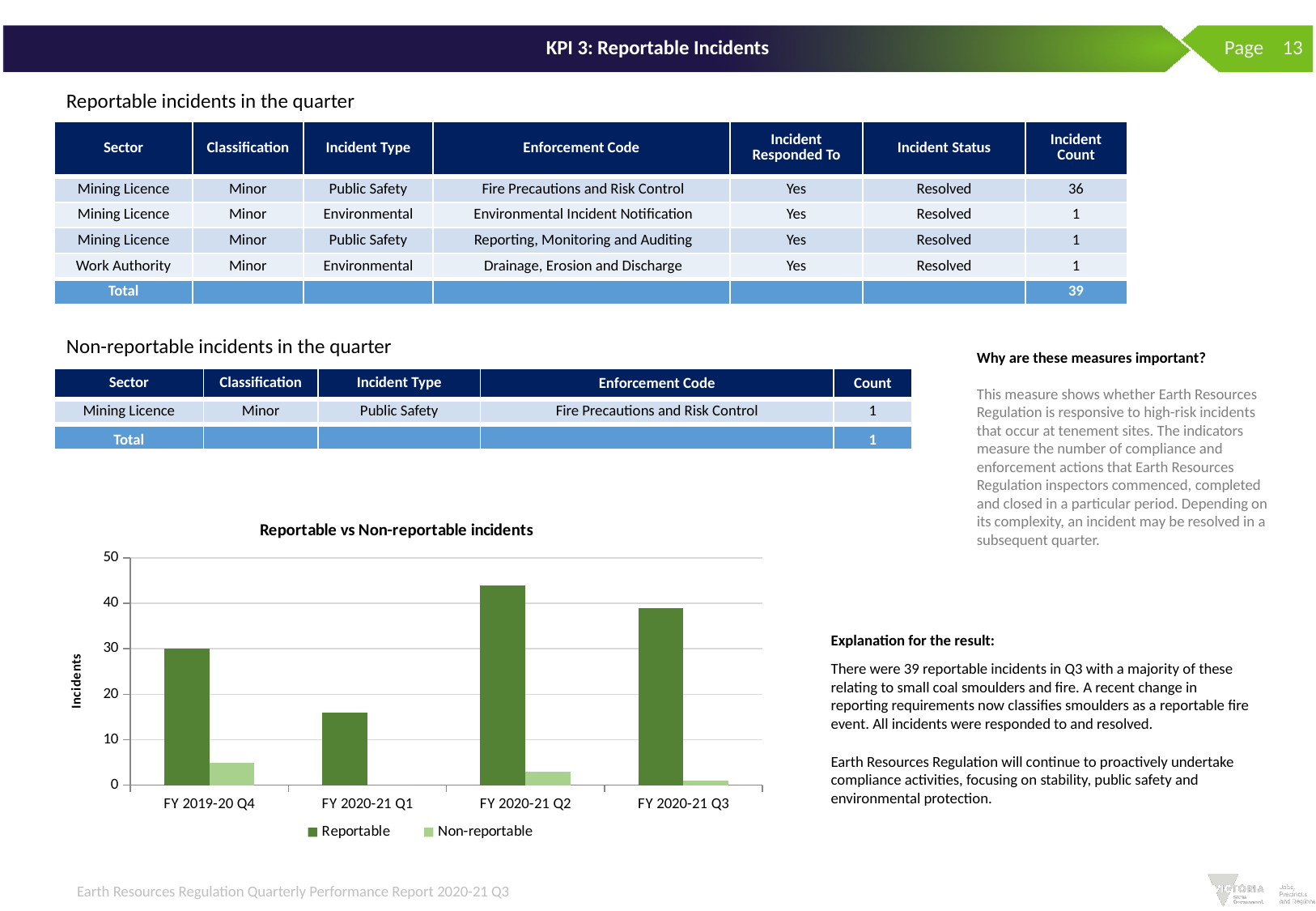
In the 'Reportable vs Non-reportable incidents' chart, which quarter has the highest Non-reportable value? FY 2019-20 Q4 What is the label on the y axis of the 'Reportable vs Non-reportable incidents' chart? Incidents In the 'Reportable vs Non-reportable incidents' chart, is the Reportable value for FY 2020-21 Q2 greater or less than 40? greater In the 'Reportable vs Non-reportable incidents' chart, which quarter has the highest Reportable value? FY 2020-21 Q2 In the 'Reportable vs Non-reportable incidents' chart, is the Non-reportable value for FY 2019-20 Q4 greater or less than 10? less In the 'Reportable vs Non-reportable incidents' chart, which quarter has the lowest Reportable value? FY 2020-21 Q1 How many quarters are shown on the x axis of the 'Reportable vs Non-reportable incidents' chart? 4 In the 'Reportable vs Non-reportable incidents' chart, which is larger: the Reportable value for FY 2020-21 Q2 or for FY 2020-21 Q3? FY 2020-21 Q2 In the 'Reportable vs Non-reportable incidents' chart, does the Reportable value rise or fall from FY 2020-21 Q1 to FY 2020-21 Q2? rise In the 'Reportable vs Non-reportable incidents' chart, is the Reportable value for FY 2020-21 Q1 greater or less than 20? less How many series does the legend of the 'Reportable vs Non-reportable incidents' chart list? 2 What kind of chart is 'Reportable vs Non-reportable incidents'? bar chart